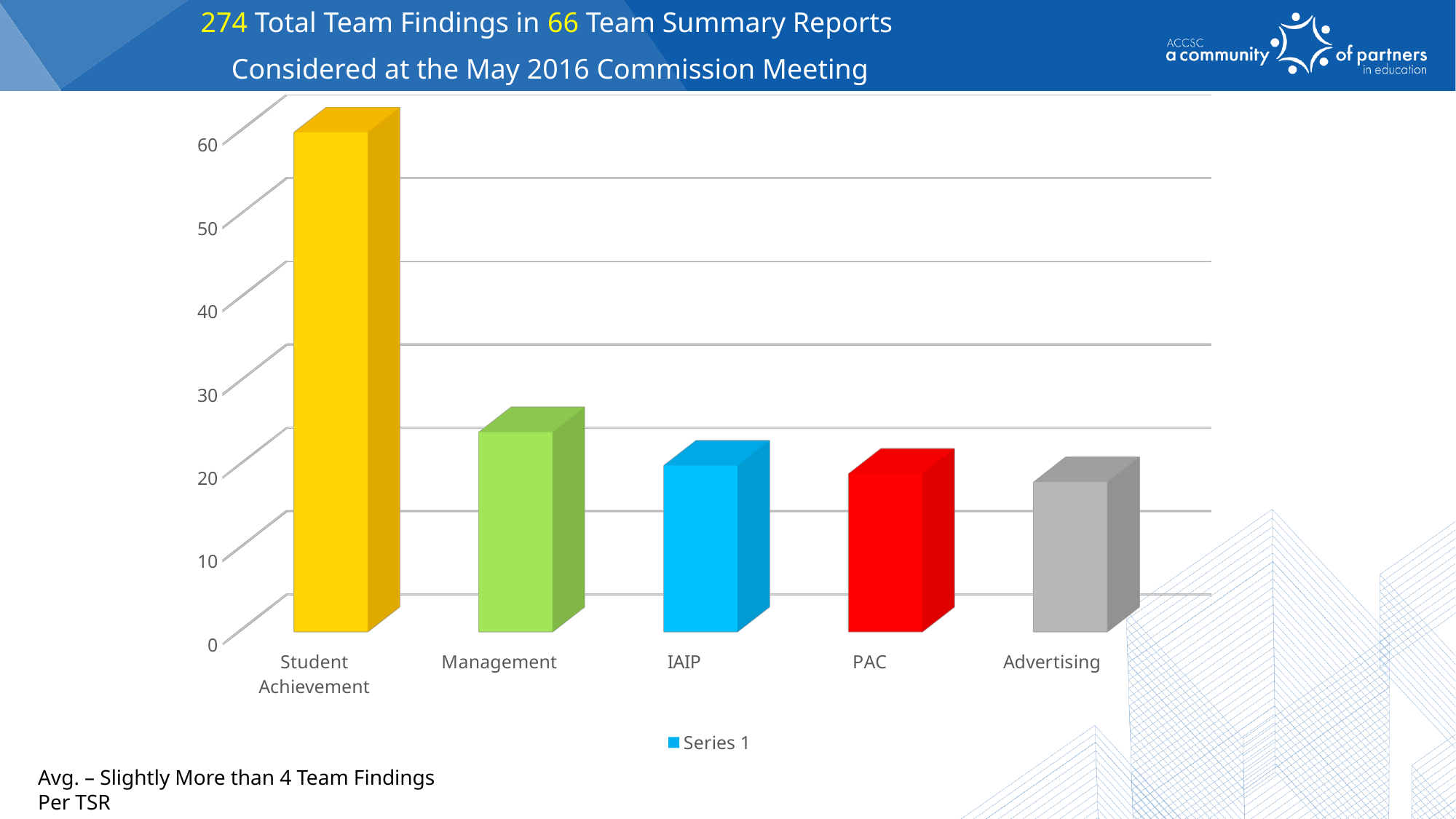
Which category has the highest value in the chart? Student Achievement How many categories are shown on the x axis of the chart? 5 Do the bar values rise or fall moving from left to right along the x axis? fall What is the name of the series listed in the chart's legend? Series 1 Which is larger, the value for Student Achievement or the value for Management? Student Achievement What kind of chart is shown on the slide? bar chart Is the value for Student Achievement greater or less than 50? greater How many series does the chart's legend list? 1 Is the value for IAIP greater or less than 30? less Is the value for Advertising greater or less than 10? greater Which category has the lowest value in the chart? Advertising